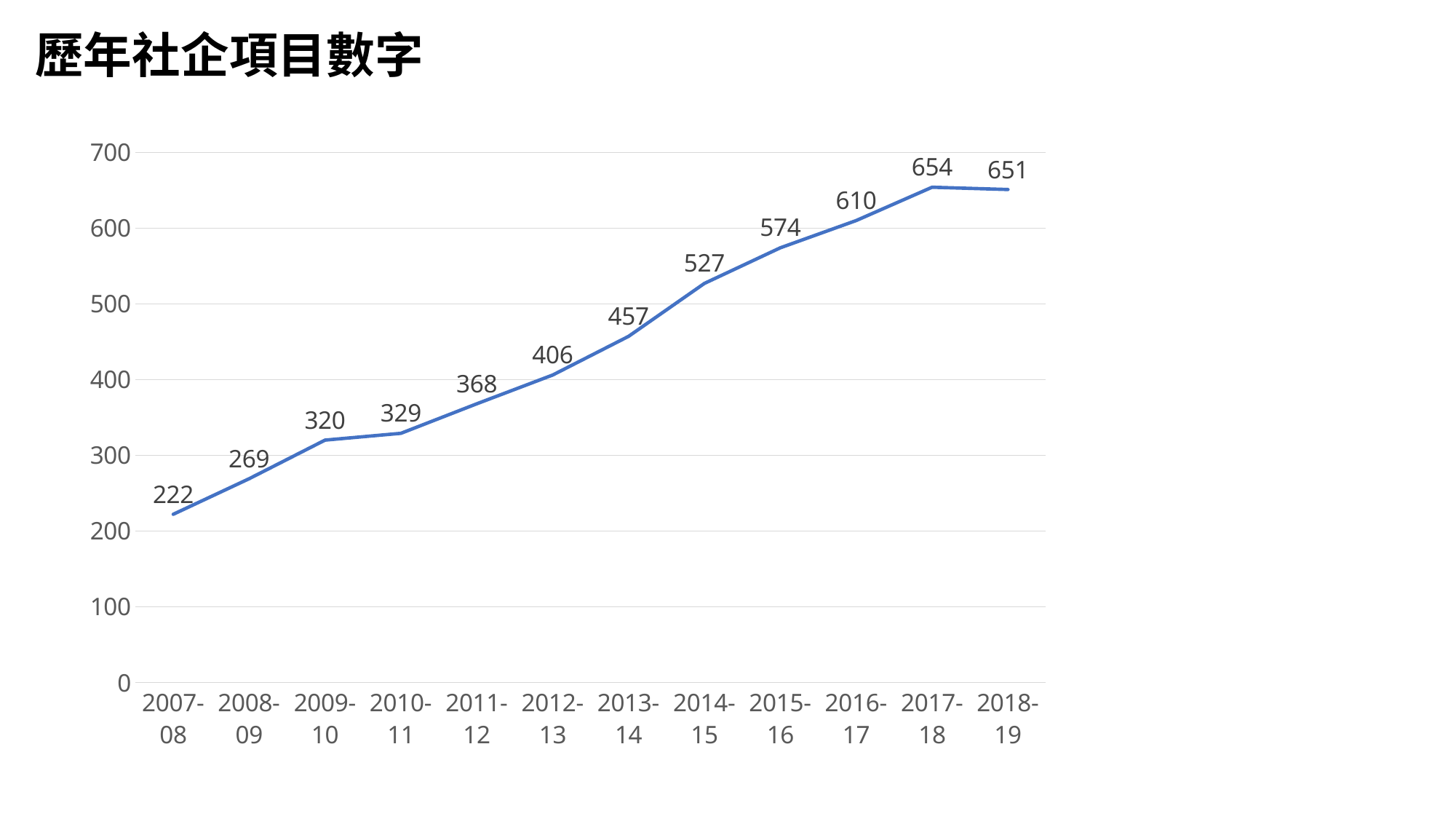
Is the value for 2015-16 greater or less than 500? greater Which year has the lowest value? 2007-08 What is the difference between the values for 2014-15 and 2013-14? 70 Which year has the highest value? 2017-18 What is the value for 2007-08? 222 What is the value for 2013-14? 457 What is the value for 2018-19? 651 How many years are plotted on the chart? 12 Which is larger, the value for 2010-11 or the value for 2011-12? 2011-12 Do the values generally rise or fall from 2007-08 to 2017-18? rise What is the difference between the values for 2017-18 and 2007-08? 432 What kind of chart is shown on the slide? line chart